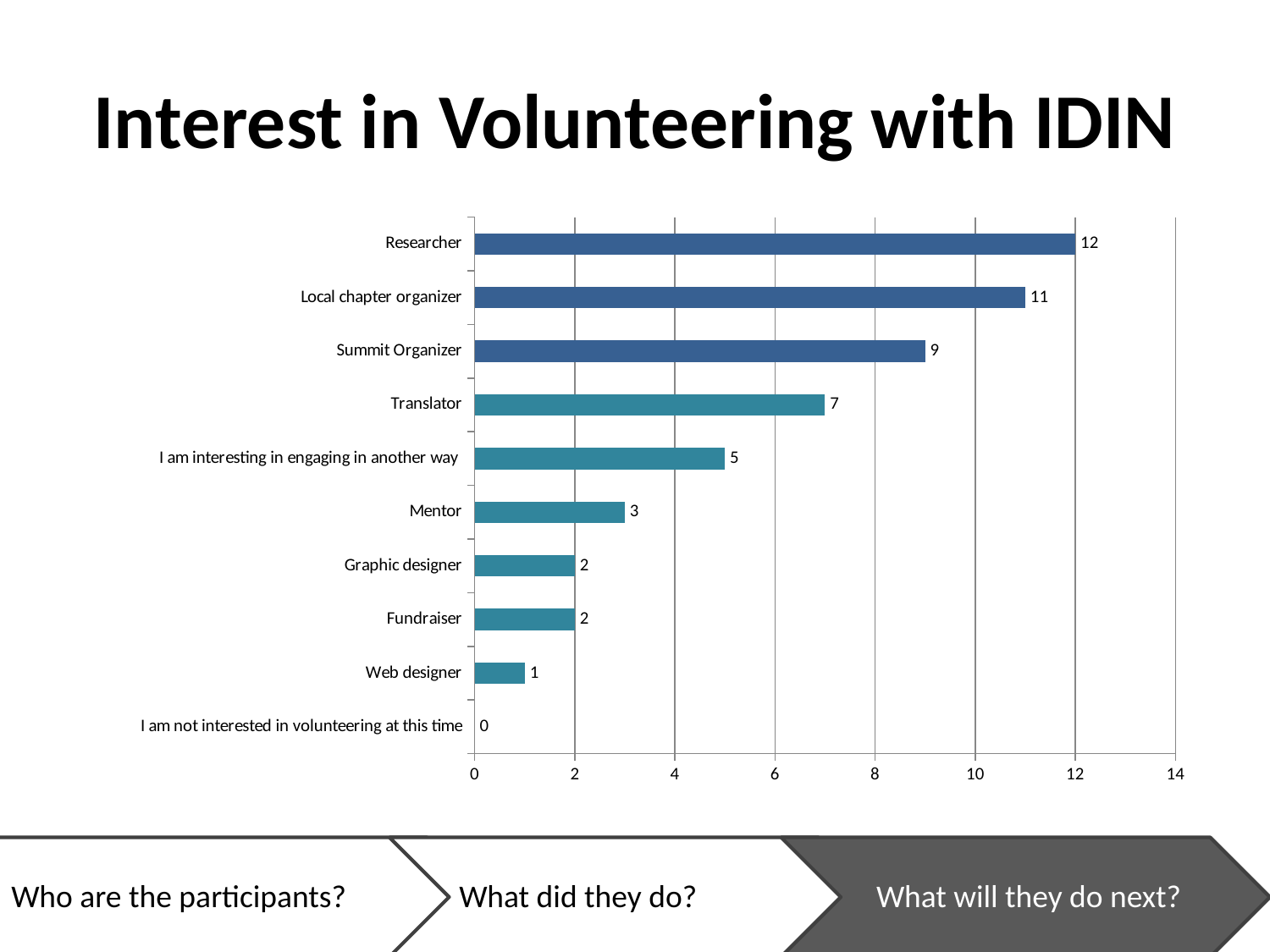
What is the value for Mentor? 3 Which category has the lowest value? I am not interested in volunteering at this time What is the title of the slide containing the chart? Interest in Volunteering with IDIN Which category has the highest value? Researcher What is the value for Researcher? 12 Is the value for Summit Organizer greater or less than 8? greater What is the difference between the values for Researcher and Summit Organizer? 3 Which is larger, the value for Local chapter organizer or the value for Translator? Local chapter organizer What kind of chart is shown on the slide? Bar chart What is the value for Translator? 7 How many categories are shown in the chart? 10 What is the value for Web designer? 1